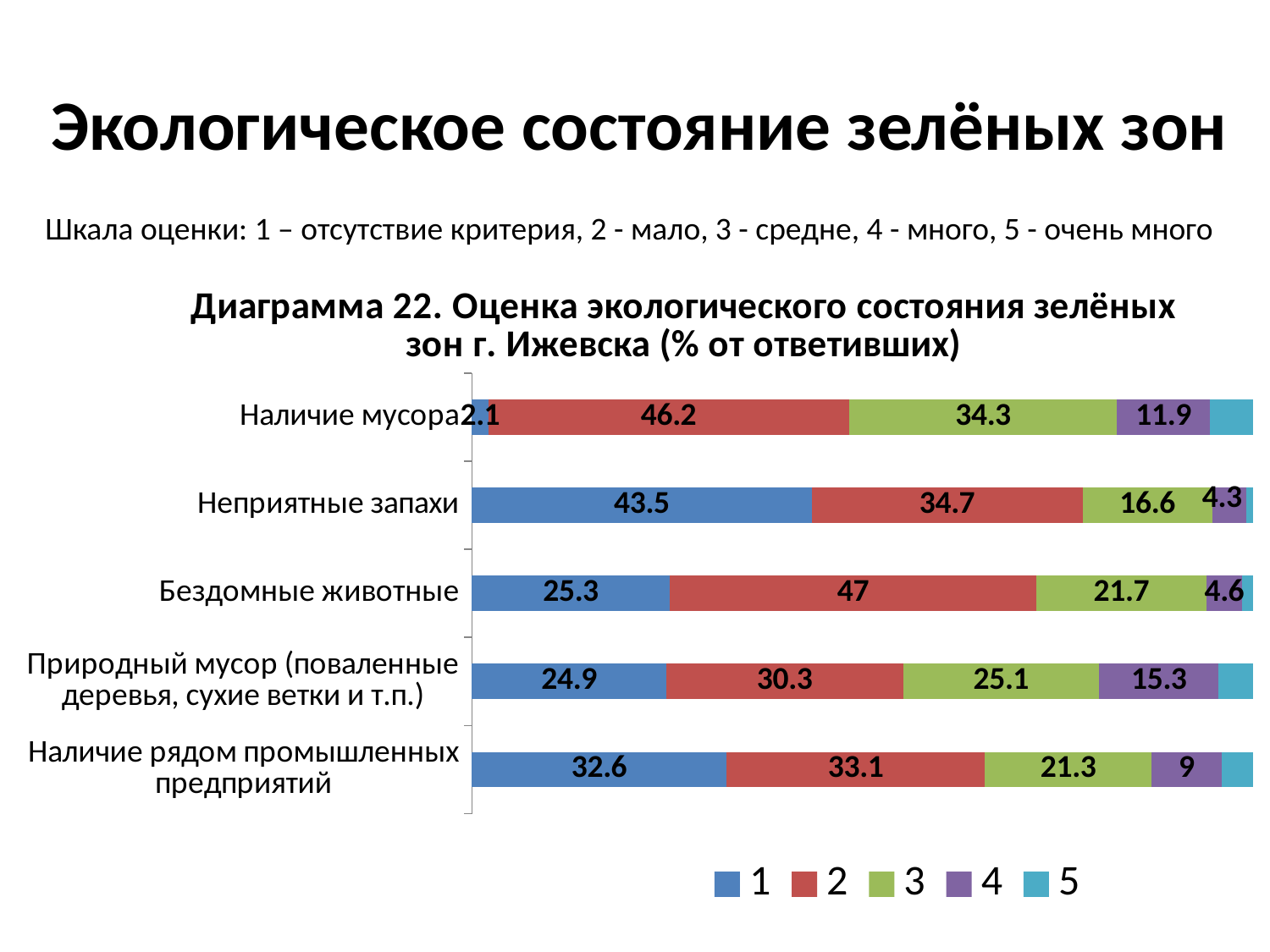
What is the value of series 3 for "Бездомные животные"? 21.7 Which is larger for "Бездомные животные": the series 1 value or the series 2 value? series 2 How many series does the legend list? 5 Which category has the highest value for series 1? Неприятные запахи What is the value of series 1 for "Неприятные запахи"? 43.5 How many categories are plotted on the chart? 5 Which category has the lowest value for series 1? Наличие мусора What is the difference between the series 2 value and the series 3 value for "Наличие мусора"? 11.9 What is the value of series 2 for "Наличие мусора"? 46.2 What kind of chart is shown on the slide? stacked bar chart What is the value of series 1 for "Наличие рядом промышленных предприятий"? 32.6 What is the value of series 4 for "Природный мусор (поваленные деревья, сухие ветки и т.п.)"? 15.3